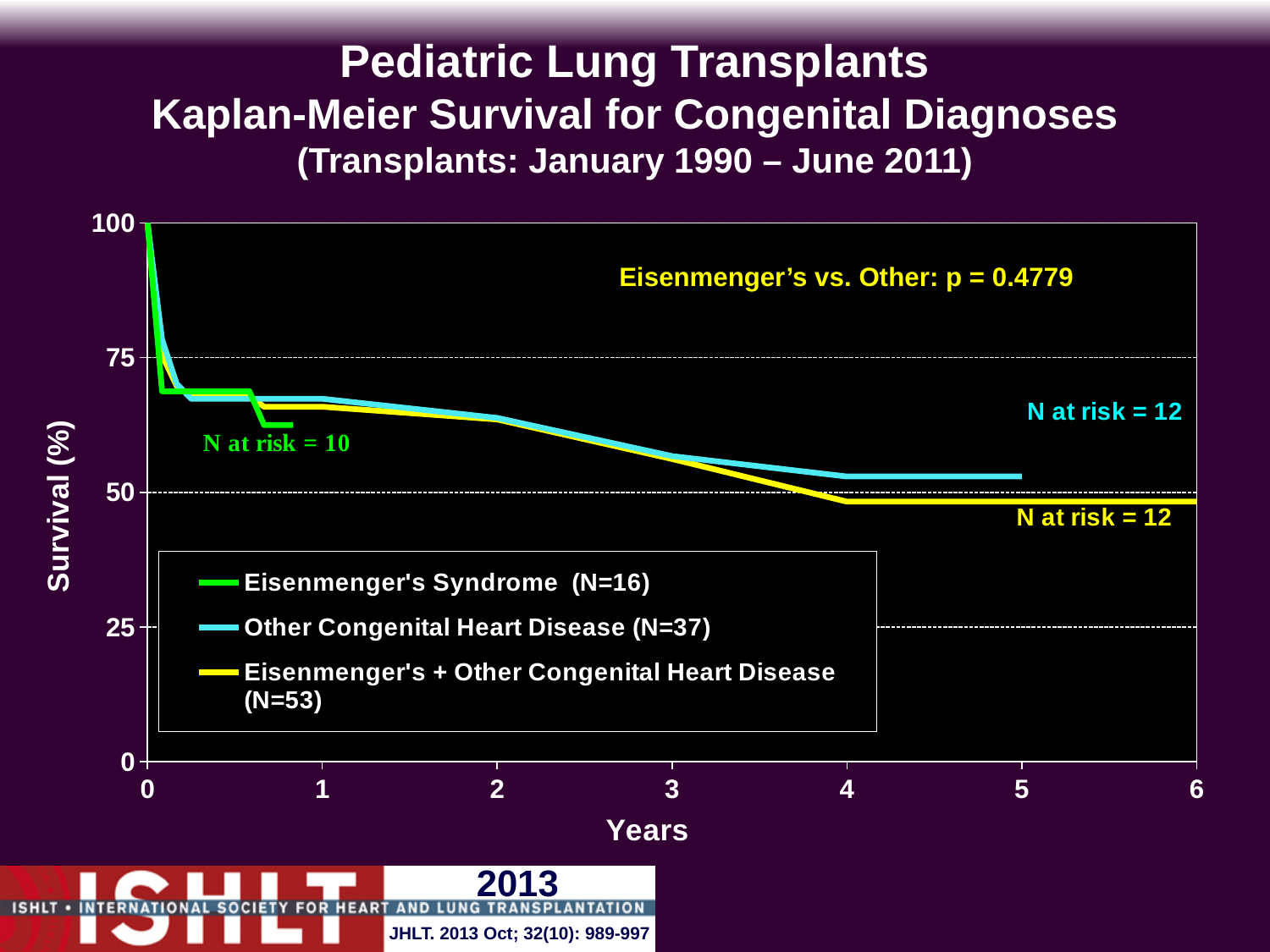
How many patients (N) are in the Eisenmenger's Syndrome group according to the legend? 16 What kind of chart is shown on the slide? line chart What is the N at risk shown for the Eisenmenger's Syndrome curve? 10 How many patients (N) are in the Other Congenital Heart Disease group according to the legend? 37 How many series does the legend list? 3 What is the N at risk shown for the Other Congenital Heart Disease curve at the end of follow-up? 12 Is the survival for Other Congenital Heart Disease at 2 years greater or less than 50? greater What is the p-value shown for Eisenmenger's vs. Other? p = 0.4779 Is the survival for Eisenmenger's + Other Congenital Heart Disease at 6 years greater or less than 75? less How many patients (N) are in the combined Eisenmenger's + Other Congenital Heart Disease group? 53 Do the survival curves rise or fall as years increase? fall What is the label of the y axis? Survival (%)